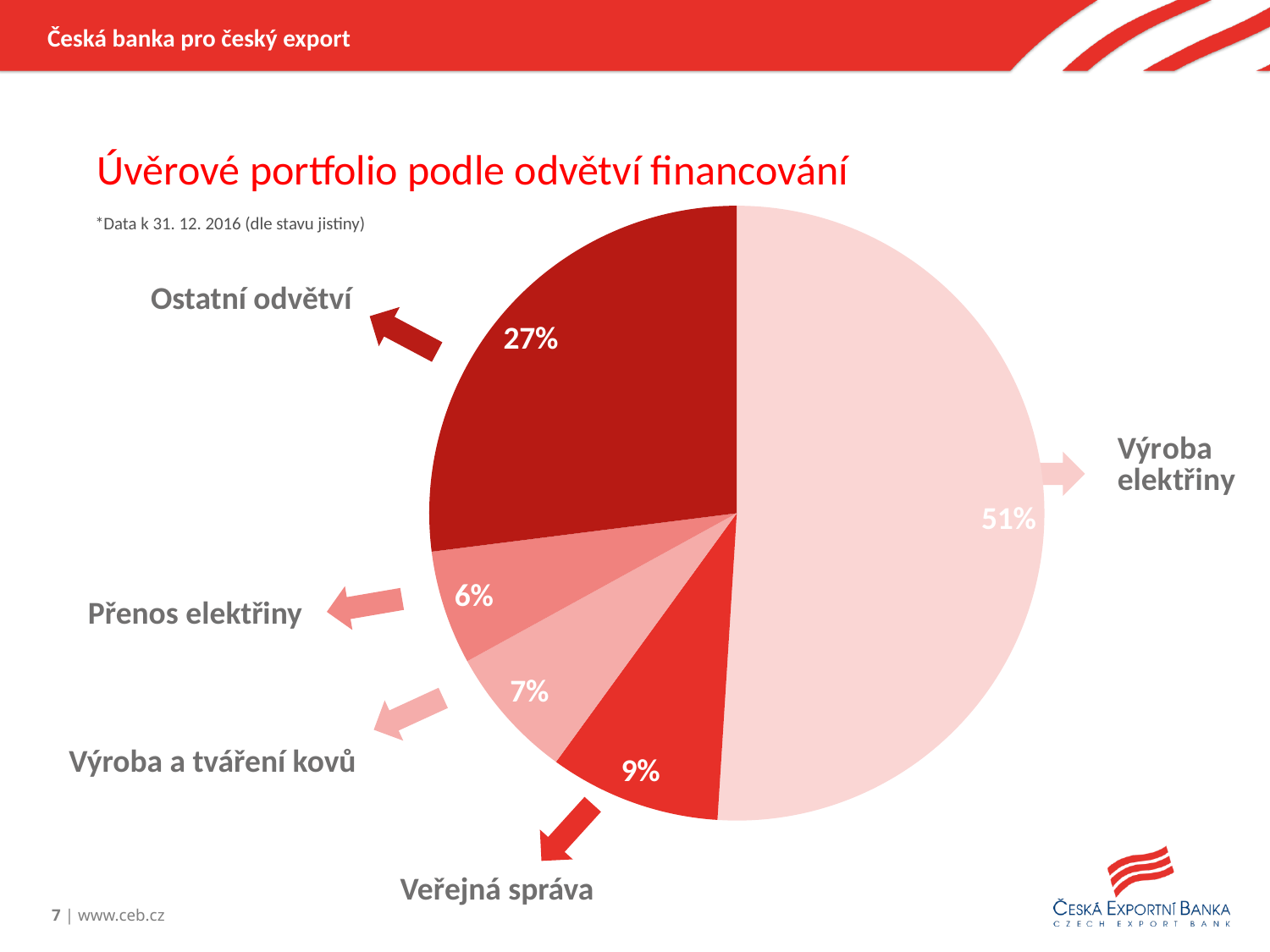
What share of the credit portfolio is Přenos elektřiny? 6% What share of the credit portfolio is Ostatní odvětví? 27% What share of the credit portfolio is Výroba a tváření kovů? 7% What share of the credit portfolio is Veřejná správa? 9% Which sector has the largest share of the credit portfolio? Výroba elektřiny Which is larger, the share for Veřejná správa or the share for Výroba a tváření kovů? Veřejná správa Which sector has the smallest share of the credit portfolio? Přenos elektřiny What share of the credit portfolio is Výroba elektřiny? 51% What is the title of the chart on the slide? Úvěrové portfolio podle odvětví financování What is the difference in percentage points between Výroba elektřiny and Ostatní odvětví? 24 What kind of chart is shown on the slide? pie chart How many sectors (slices) are shown in the pie chart? 5